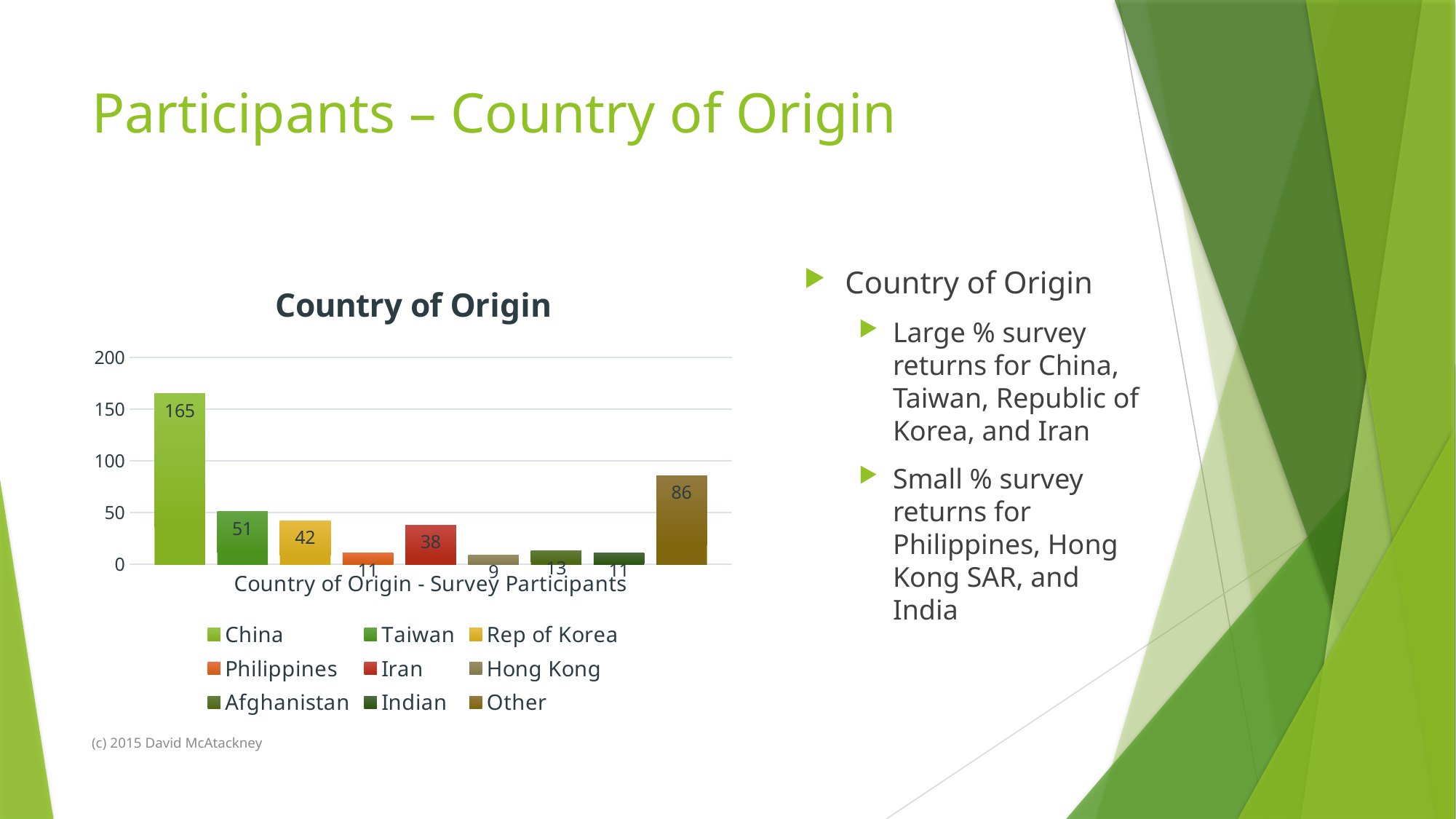
What kind of chart is the Country of Origin chart? bar chart What is the value for Iran in the Country of Origin chart? 38 What is the value for Other in the Country of Origin chart? 86 What is the x-axis label of the Country of Origin chart? Country of Origin - Survey Participants Which country has the highest value in the Country of Origin chart? China What is the value for Rep of Korea in the Country of Origin chart? 42 Which country has the lowest value in the Country of Origin chart? Hong Kong Is the value for Other in the Country of Origin chart greater or less than 100? less How many series does the legend of the Country of Origin chart list? 9 What is the value for China in the Country of Origin chart? 165 Which is larger in the Country of Origin chart, Taiwan or Rep of Korea? Taiwan What is the difference between the values for China and Other in the Country of Origin chart? 79